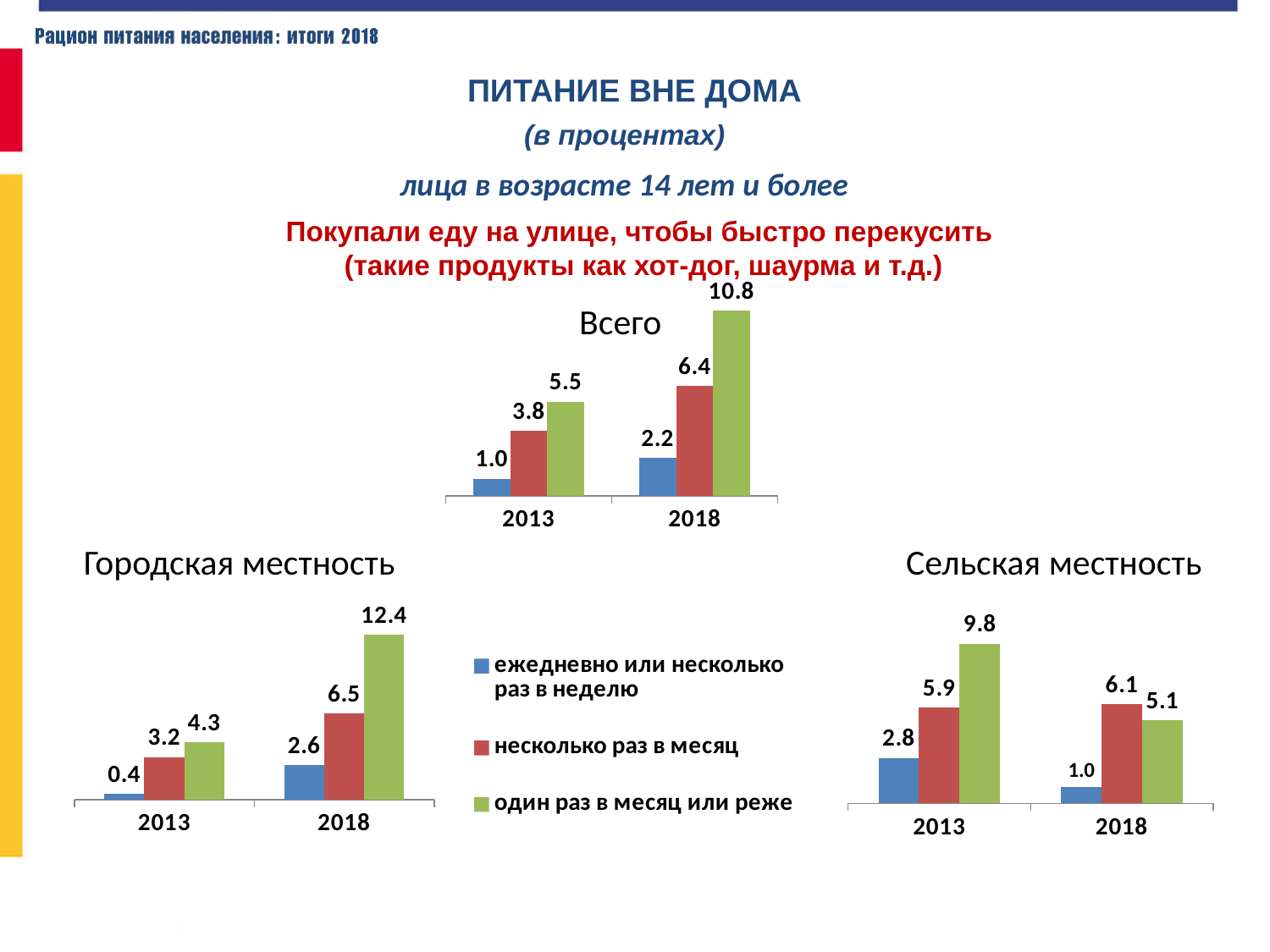
In the 'Всего' chart, what is the value for 'один раз в месяц или реже' in 2018? 10.8 In the 'Сельская местность' chart, does the value for 'ежедневно или несколько раз в неделю' rise or fall from 2013 to 2018? fall In the 'Городская местность' chart, which series has the lowest value in 2013? ежедневно или несколько раз в неделю What kind of chart is the 'Городская местность' chart? bar chart In the 'Сельская местность' chart, what is the value for 'один раз в месяц или реже' in 2013? 9.8 How many series does the legend list? 3 In the 'Городская местность' chart, what is the value for 'несколько раз в месяц' in 2018? 6.5 In the 'Городская местность' chart, which series has the highest value in 2018? один раз в месяц или реже In the 'Сельская местность' chart, which is larger in 2018: 'несколько раз в месяц' or 'один раз в месяц или реже'? несколько раз в месяц In the 'Всего' chart, what is the value for 'ежедневно или несколько раз в неделю' in 2013? 1.0 In the 'Всего' chart, what is the difference between the 2018 and 2013 values for 'один раз в месяц или реже'? 5.3 How many year categories are shown on the x axis of the 'Всего' chart? 2